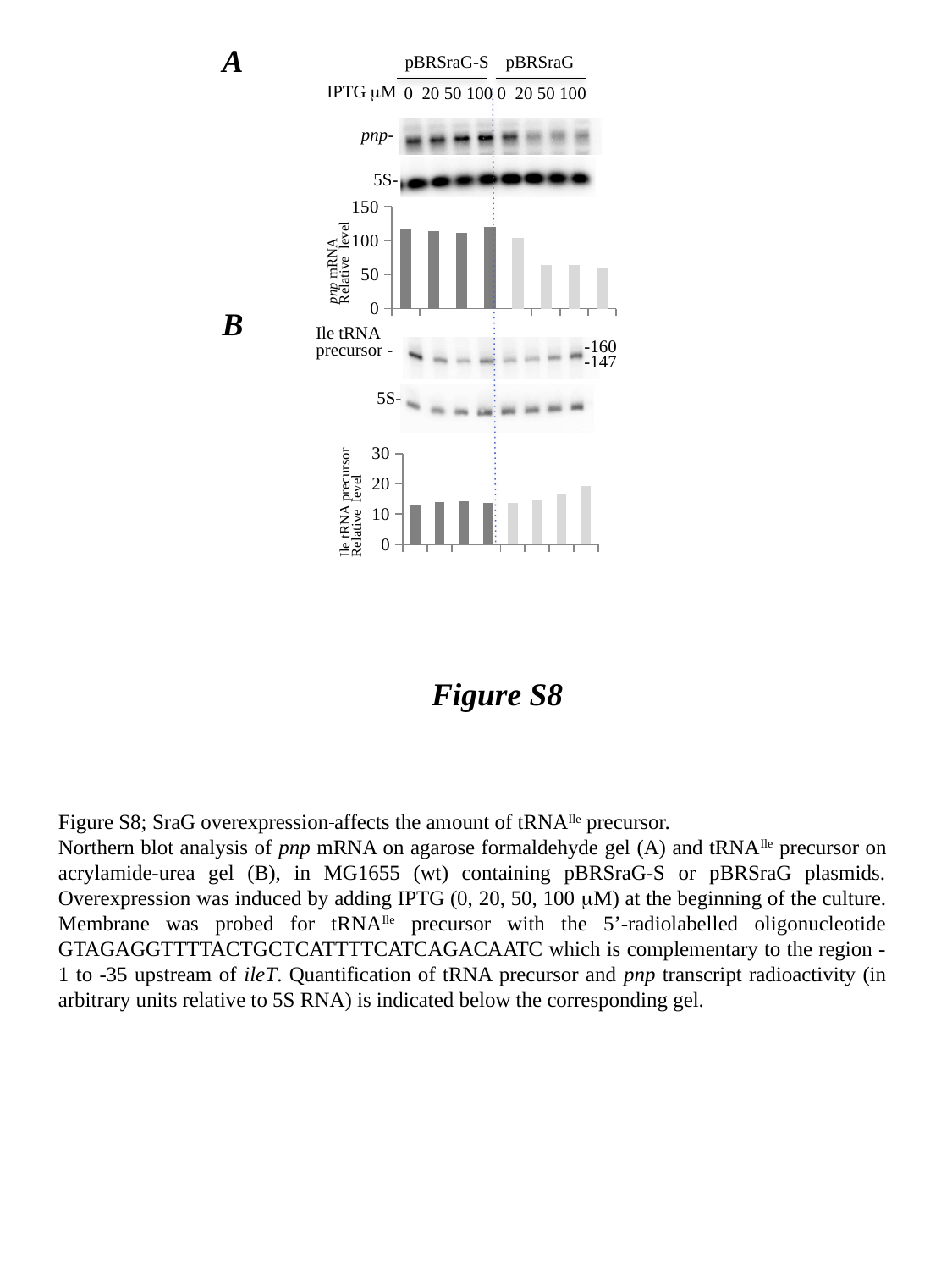
In the panel B chart, is the Ile tRNA precursor relative level for pBRSraG-S at 0 µM IPTG greater or less than 10? greater In the panel A chart, is the pnp mRNA relative level for pBRSraG at 0 µM IPTG greater or less than 50? greater In the panel A chart, which is larger: the pnp mRNA relative level for pBRSraG-S at 100 µM IPTG or for pBRSraG at 100 µM IPTG? pBRSraG-S at 100 µM IPTG In the panel B chart (Ile tRNA precursor relative level), how many bars are plotted? 8 In the panel A chart, is the pnp mRNA relative level for pBRSraG-S at 0 µM IPTG greater or less than 100? greater In the panel B chart, do the Ile tRNA precursor relative levels for pBRSraG rise or fall as the IPTG concentration increases from 0 to 100 µM? rise In the panel A chart (pnp mRNA relative level), how many bars are plotted? 8 In the panel A chart, do the pnp mRNA relative levels for pBRSraG rise or fall as the IPTG concentration increases from 0 to 100 µM? fall In the panel B chart, what is the highest value shown on the y axis? 30 In the panel B chart, which bar has the highest Ile tRNA precursor relative level? pBRSraG at 100 µM IPTG In the panel A chart (pnp mRNA relative level), what kind of chart is shown? bar chart